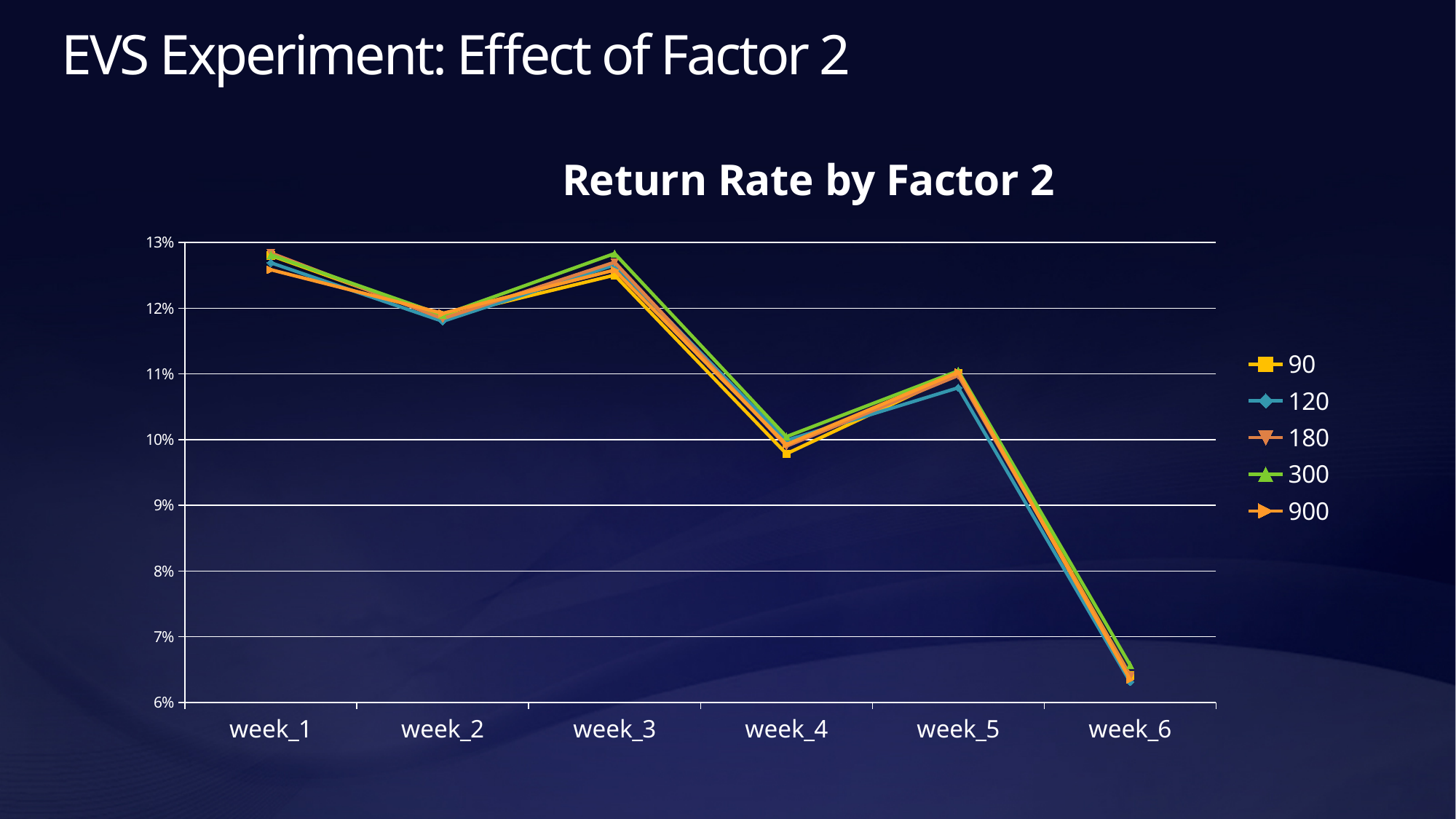
For series 300, which week has the lowest return rate? week_6 What kind of chart is shown on the slide? line chart Which series are listed in the legend? 90, 120, 180, 300, 900 How many series does the legend list? 5 Is the value for series 120 at week_5 greater or less than 10%? greater Is the value for series 900 at week_3 greater or less than 12%? greater How many weeks are shown on the x axis? 6 What is the title of the chart? Return Rate by Factor 2 Overall, do the return rates rise or fall from week_1 to week_6? fall Is the value for series 90 at week_1 greater or less than 12%? greater For series 90, is the value at week_1 or at week_6 larger? week_1